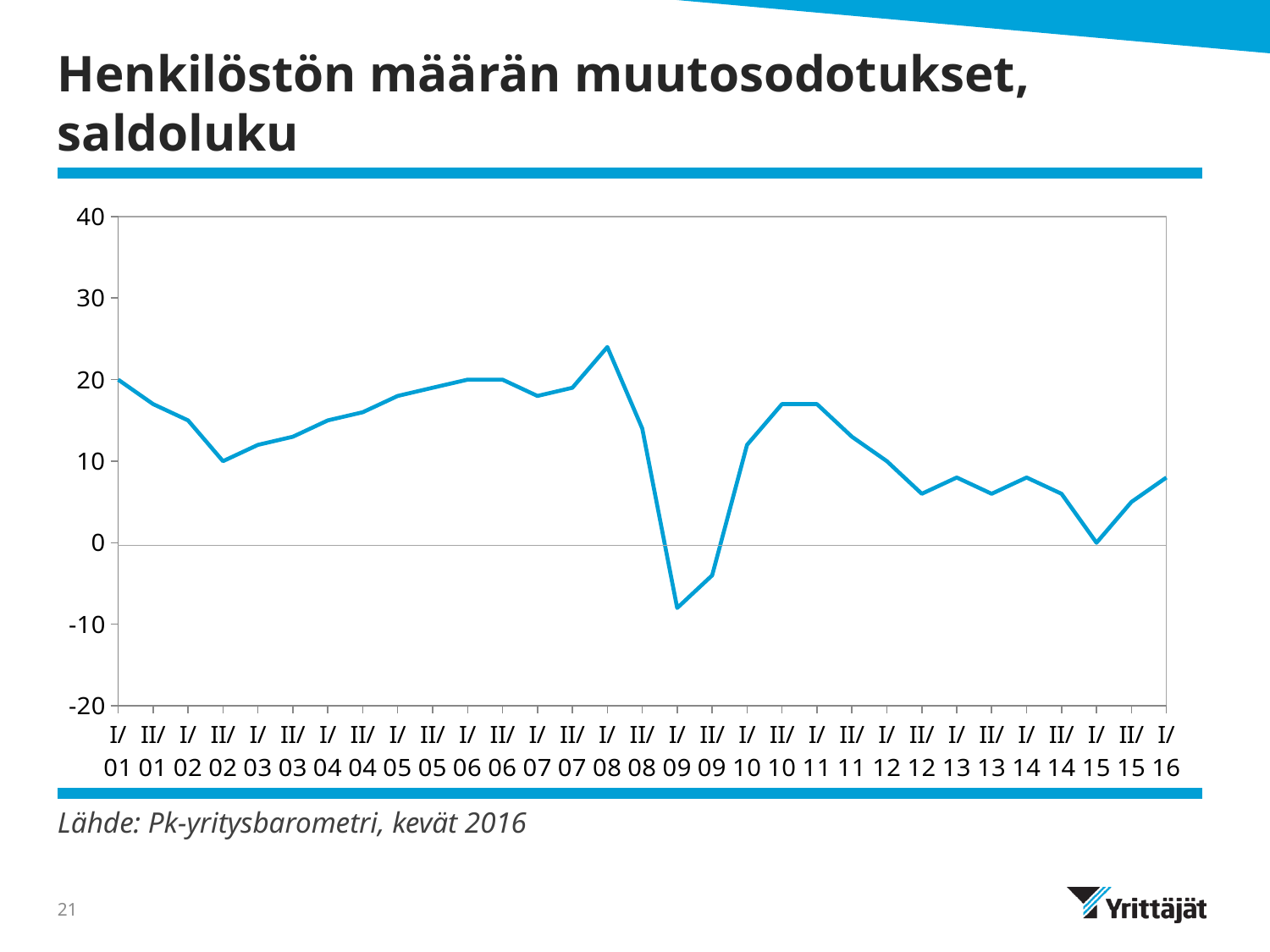
Is the value for I/08 greater or less than 20? greater At which period does the line reach its highest value? I/08 At which period does the line reach its lowest value? I/09 Which is larger, the value for II/10 or the value for I/16? II/10 What is the title of the chart on the slide? Henkilöstön määrän muutosodotukset, saldoluku Is the value for I/09 greater or less than 0? less How many data points are plotted on the line, from I/01 to I/16? 31 What source is cited below the chart? Pk-yritysbarometri, kevät 2016 What is the value for I/15? 0 What kind of chart is shown on the slide? line chart Is the value for I/16 greater or less than 10? less What is the value for I/01? 20